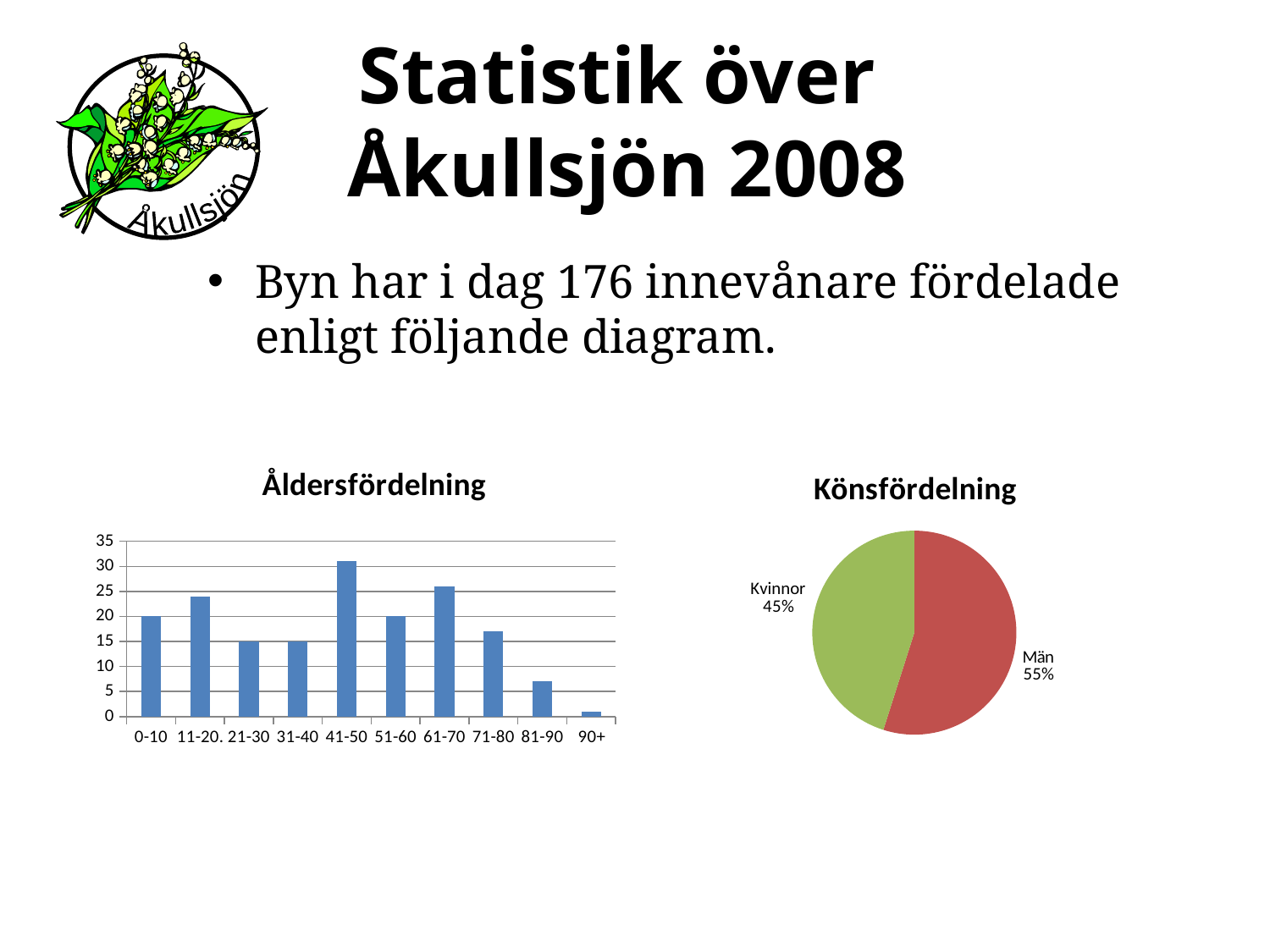
What kind of chart is the Könsfördelning chart? Pie chart In the Könsfördelning pie chart, what share is Kvinnor? 45% In the Åldersfördelning chart, is the value for 81-90 greater or less than 10? less What kind of chart is the Åldersfördelning chart? Bar chart In the Åldersfördelning chart, which age group has the lowest bar? 90+ In the Åldersfördelning chart, which is larger, the value for 71-80 or the value for 61-70? 61-70 In the Könsfördelning pie chart, what share is Män? 55% In the Åldersfördelning chart, is the value for 41-50 greater or less than 30? greater In the Åldersfördelning chart, which is larger, the value for 11-20 or the value for 21-30? 11-20 In the Åldersfördelning chart, which age group has the highest bar? 41-50 How many age groups are shown on the x axis of the Åldersfördelning chart? 10 In the Åldersfördelning chart, is the value for 61-70 greater or less than 25? greater